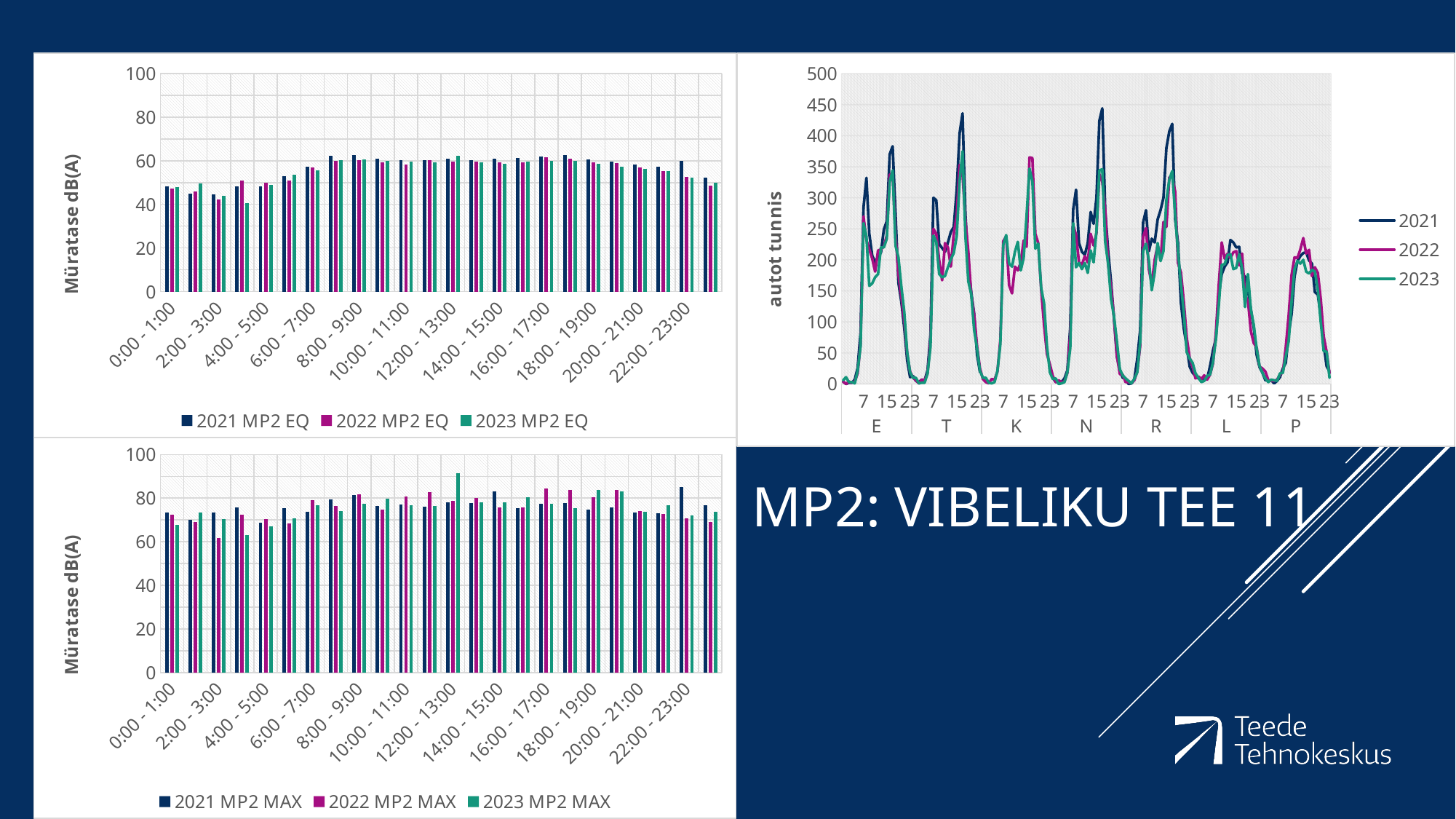
In the right-hand line chart, which series reaches the highest peak on day N? 2021 In the top-left chart, how many series does the legend list? 3 What is the y-axis label of the right-hand line chart? autot tunnis In the top-left chart, is the value for 2022 MP2 EQ at 2:00 - 3:00 greater or less than 60? less In the right-hand line chart, how many series does the legend list? 3 In the bottom-left chart, is the value for 2023 MP2 MAX at 12:00 - 13:00 greater or less than 80? greater In the right-hand line chart, is the peak value of the 2021 line on day N greater or less than 400? greater What is the y-axis label of the bottom-left bar chart? Müratase dB(A) What kind of chart is the top-left chart on the slide? bar chart In the right-hand line chart, how many day groups (E, T, K, N, R, L, P) are shown along the x axis? 7 What kind of chart is the chart on the right side of the slide (with the 'autot tunnis' axis)? line chart